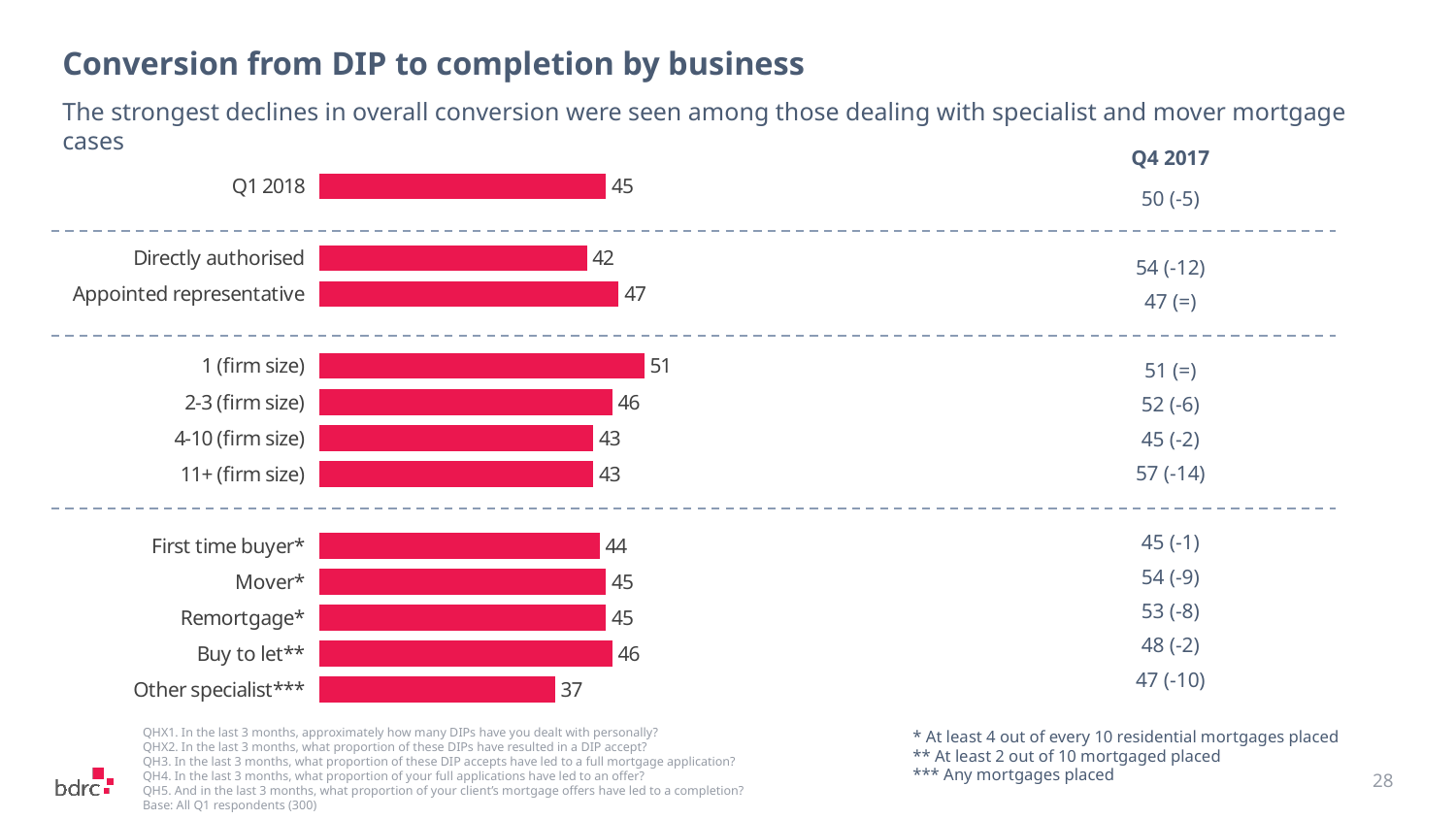
What is the value for Q1 2018 overall? 45 What is the difference between the values for Appointed representative and Directly authorised? 5 What is the value for Directly authorised? 42 Which category has the lowest value in the chart? Other specialist*** What is the value for Other specialist*** in the bar chart? 37 What colour are the bars in the chart? Red Which is larger, the value for Buy to let** or the value for First time buyer*? Buy to let** Which category has the highest value in the chart? 1 (firm size) What is the value for 1 (firm size)? 51 How many bars are shown in the chart? 12 What type of chart is shown on the slide? Bar chart What is the difference between the values for 1 (firm size) and Other specialist***? 14